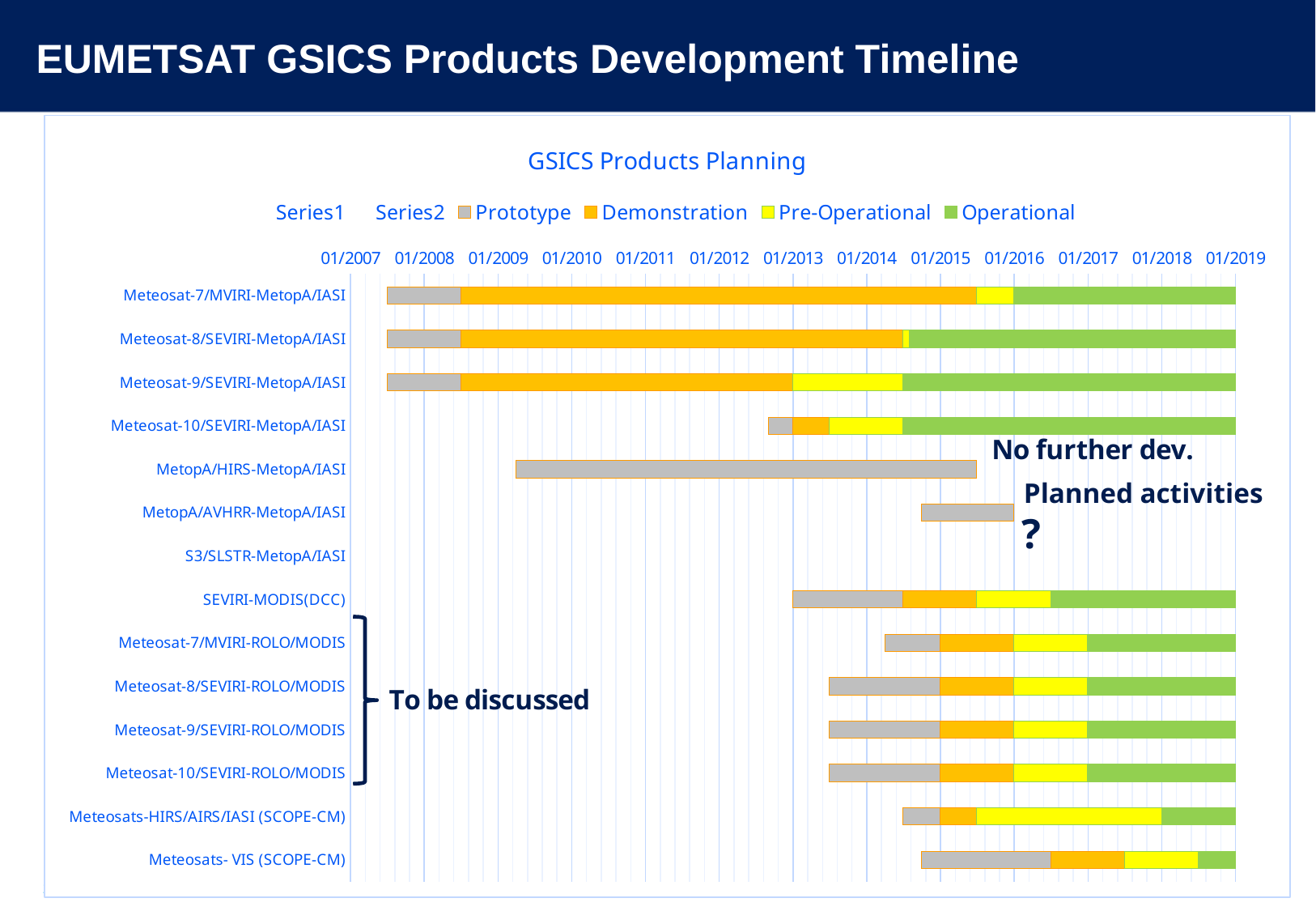
What is the last date label shown on the horizontal axis? 01/2019 What is the title of the chart? GSICS Products Planning Does the Operational segment for Meteosat-9/SEVIRI-MetopA/IASI begin before or after 01/2015? before Does the bar for MetopA/HIRS-MetopA/IASI start before or after 01/2010? before What kind of chart is shown on the slide? bar chart Which category has the longest Prototype (grey) segment? MetopA/HIRS-MetopA/IASI How many product categories are listed on the vertical axis of the chart? 14 How many categories are grouped under the 'To be discussed' bracket? 4 Does the bar for Meteosat-10/SEVIRI-MetopA/IASI start before or after 01/2013? before Which category on the chart has no bar plotted at all? S3/SLSTR-MetopA/IASI Which category has the longest Pre-Operational (yellow) segment? Meteosats-HIRS/AIRS/IASI (SCOPE-CM) How many entries does the chart legend list? 6